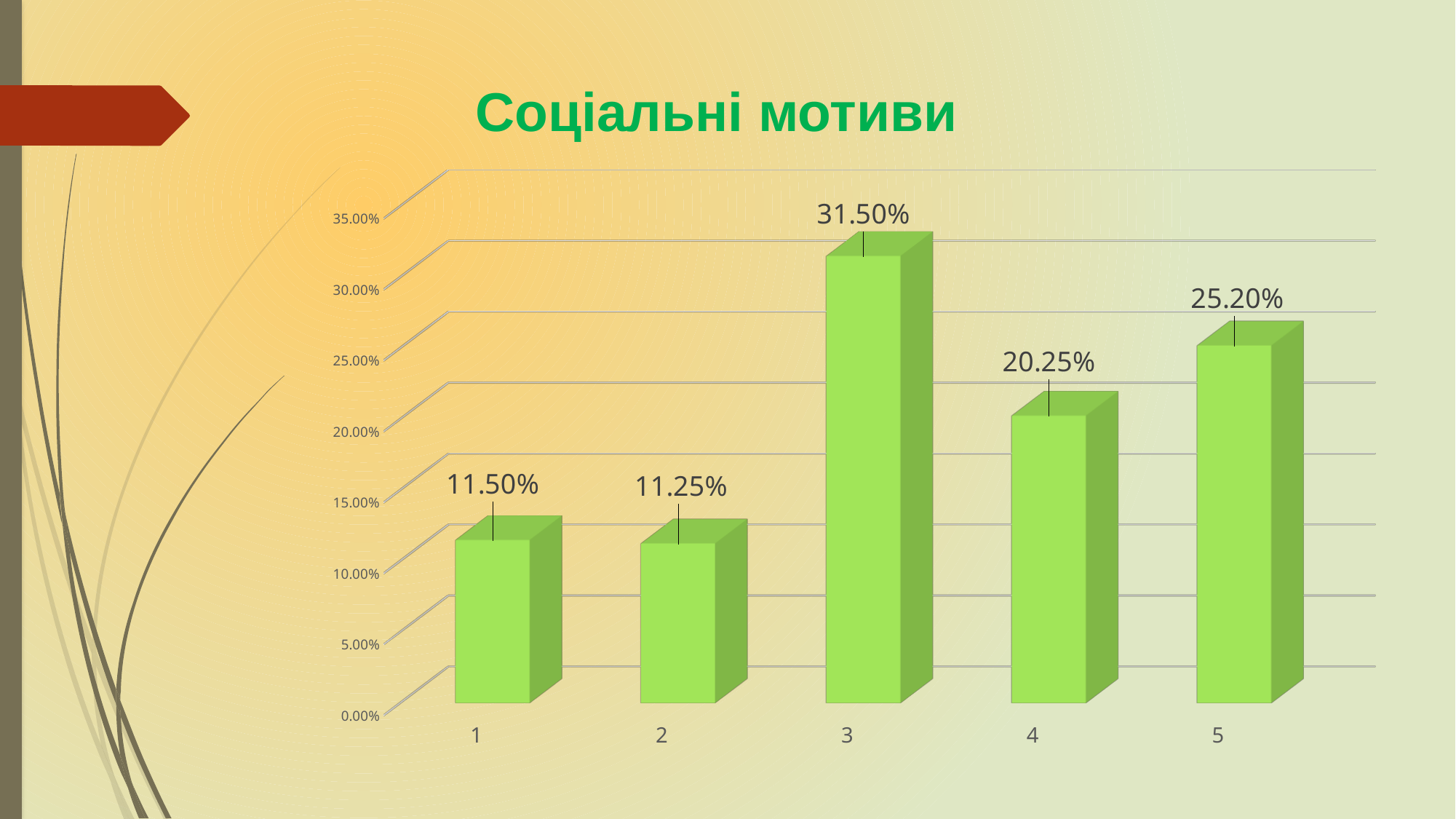
What is the value for category 5? 25.20% Which is larger, the value for category 4 or the value for category 5? 5 What is the difference between the values for category 3 and category 5? 6.30% What is the difference between the values for category 1 and category 2? 0.25% Which category has the lowest value? 2 What is the value for category 1? 11.50% How many categories are shown on the chart? 5 What is the value for category 4? 20.25% What is the title of the slide above the chart? Соціальні мотиви What is the value for category 3? 31.50% What kind of chart is shown on the slide? bar chart Which category has the highest value? 3